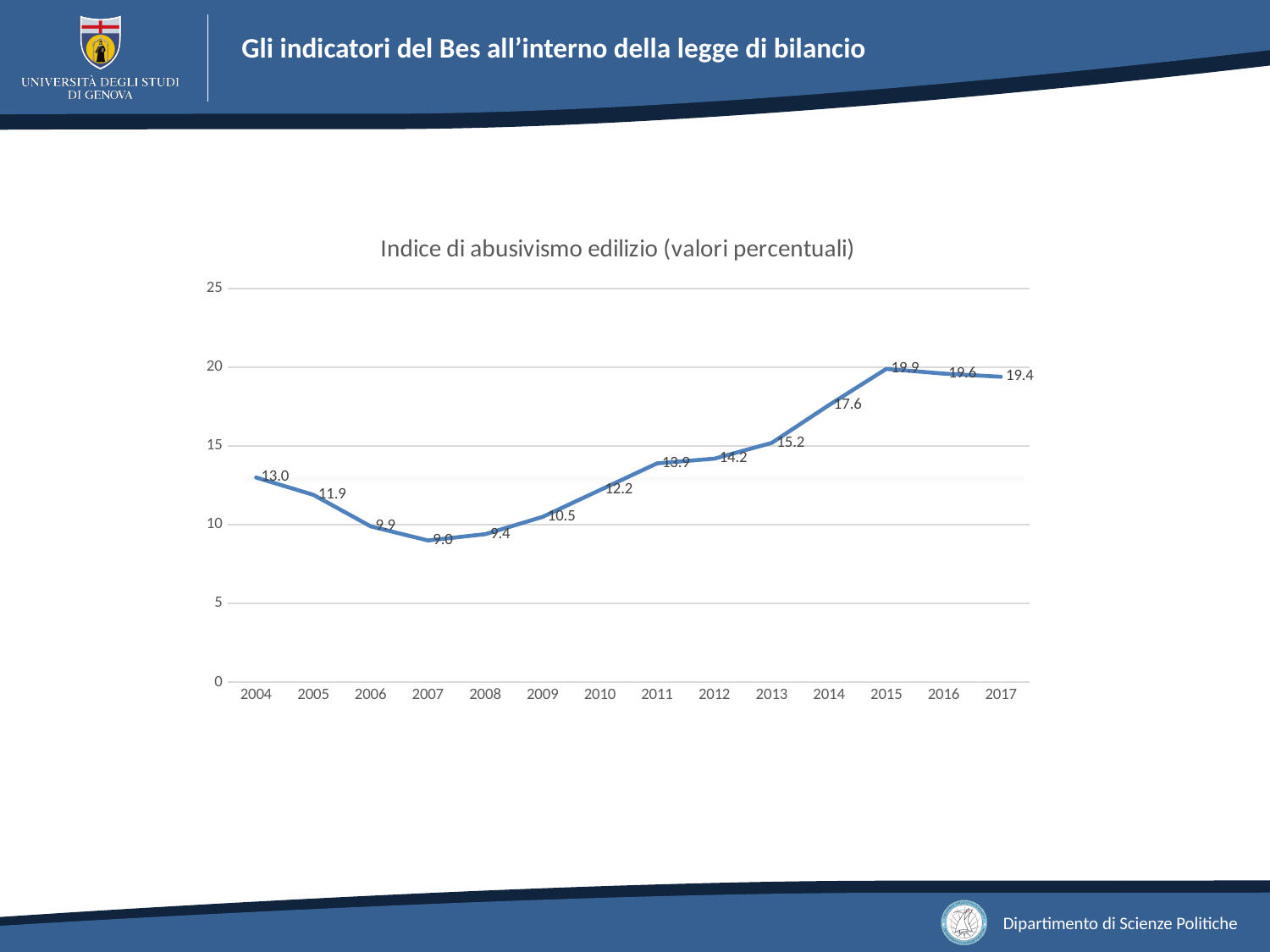
Which year has the lowest value? 2007 What is the title of the chart? Indice di abusivismo edilizio (valori percentuali) How many years are plotted on the x axis? 14 What is the value for 2010? 12.2 What is the value for 2004? 13.0 What kind of chart is shown on the slide? line chart Is the value for 2014 greater or less than 15? greater Which is larger, the value for 2009 or the value for 2012? 2012 Do the values rise or fall from 2007 to 2015? rise Which year has the highest value? 2015 What is the value for 2017? 19.4 What is the difference between the values for 2015 and 2004? 6.9